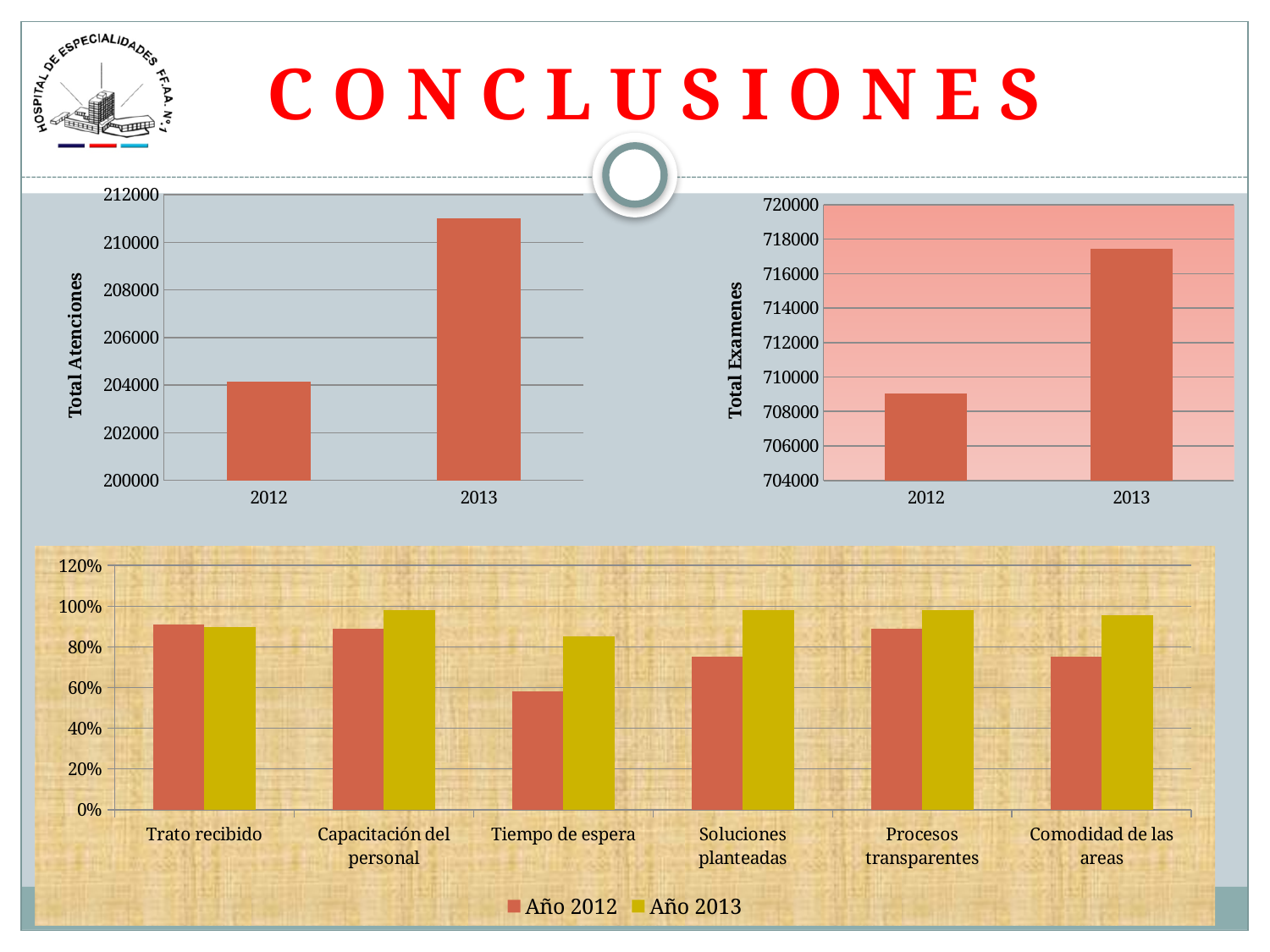
In the 'Total Examenes' chart at the top right, is the value for 2012 greater or less than 710000? less In the 'Total Atenciones' chart, is the value for 2013 greater or less than 210000? greater In the 'Total Examenes' chart, do the values rise or fall from 2012 to 2013? rise What kind of chart is the 'Total Atenciones' chart at the top left of the slide? bar chart In the bottom chart, which category has the lowest value for Año 2012? Tiempo de espera In the 'Total Atenciones' chart, which year has the higher value, 2012 or 2013? 2013 How many series does the legend of the bottom chart list? 2 How many categories are shown on the x axis of the bottom chart? 6 In the 'Total Atenciones' chart, is the value for 2012 greater or less than 206000? less In the bottom chart, for 'Tiempo de espera', which series is larger, Año 2012 or Año 2013? Año 2013